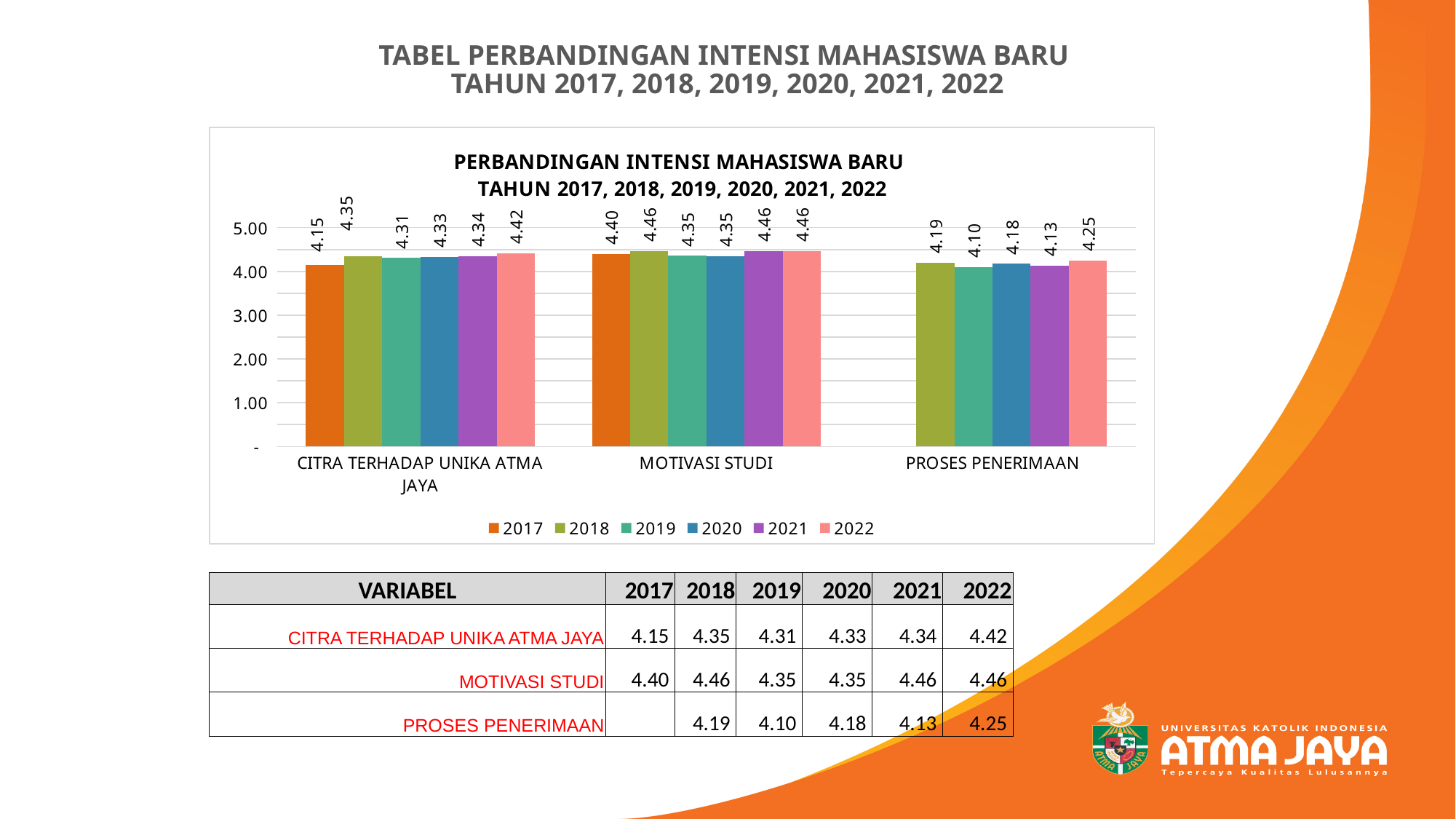
What is the value for CITRA TERHADAP UNIKA ATMA JAYA in 2017? 4.15 Which year has the lowest value for PROSES PENERIMAAN? 2019 What is the value for PROSES PENERIMAAN in 2019? 4.10 Which is larger, the 2018 value for MOTIVASI STUDI or the 2018 value for PROSES PENERIMAAN? MOTIVASI STUDI Which series is shown in orange in the chart legend? 2017 Is the 2021 value for MOTIVASI STUDI greater or less than 4.00? greater What is the value for MOTIVASI STUDI in 2022? 4.46 What type of chart is shown on the slide? bar chart Which year has the highest value for CITRA TERHADAP UNIKA ATMA JAYA? 2022 How many categories are shown on the x axis of the chart? 3 What is the difference between the 2022 and 2017 values for CITRA TERHADAP UNIKA ATMA JAYA? 0.27 How many series does the chart legend list? 6